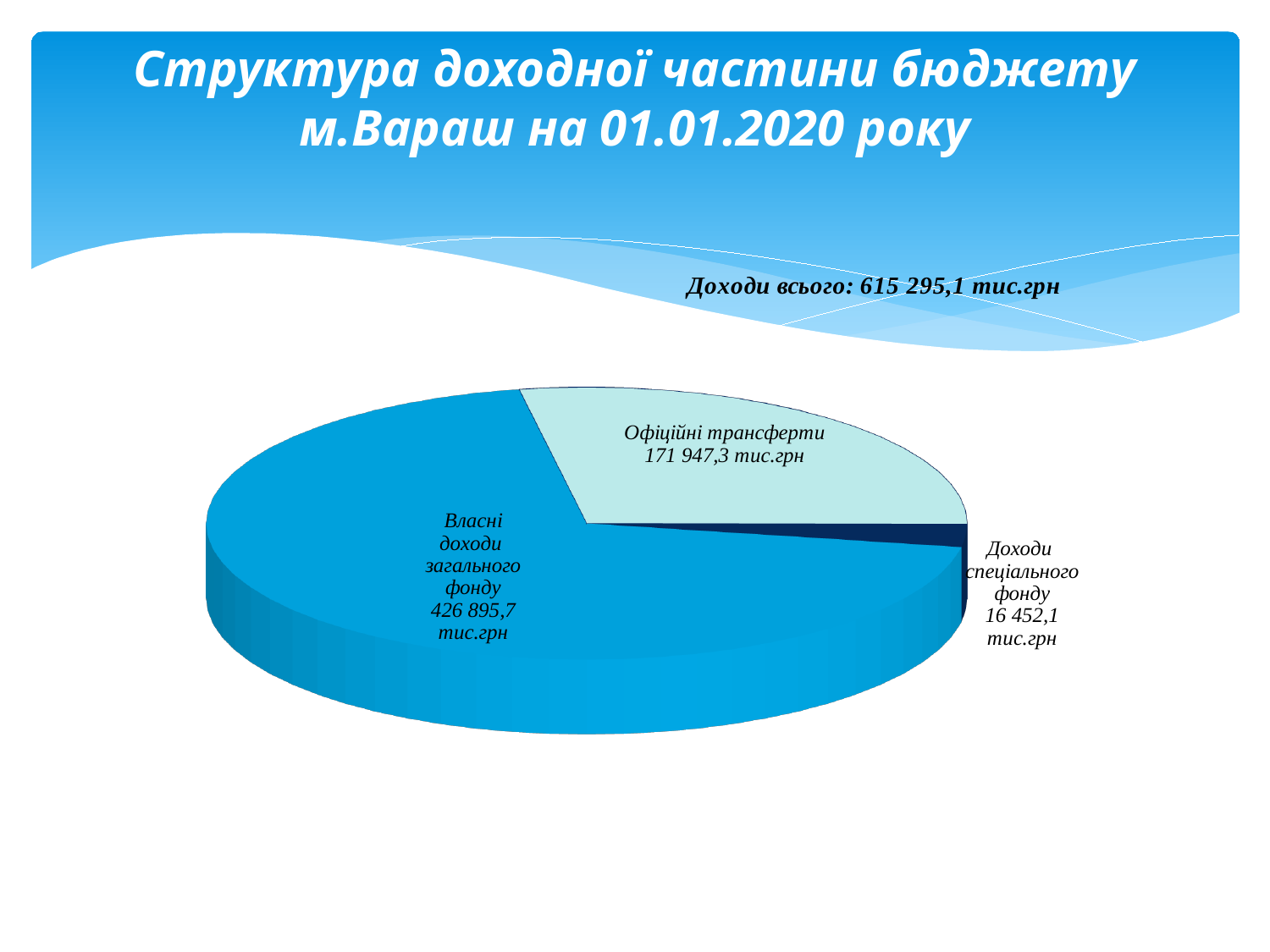
What is the difference between Офіційні трансферти and Доходи спеціального фонду? 155 495,2 тис.грн Which category has the smallest slice of the pie? Доходи спеціального фонду Which category has the largest slice of the pie? Власні доходи загального фонду How many slices does the pie chart have? 3 What is the difference between Власні доходи загального фонду and Офіційні трансферти? 254 948,4 тис.грн Which is larger, Офіційні трансферти or Доходи спеціального фонду? Офіційні трансферти What is the value for Власні доходи загального фонду? 426 895,7 тис.грн What type of chart is shown on the slide? Pie chart What is the total income (Доходи всього) shown on the slide? 615 295,1 тис.грн What is the value for Доходи спеціального фонду? 16 452,1 тис.грн What is the title of the slide containing the chart? Структура доходної частини бюджету м.Вараш на 01.01.2020 року What is the value for Офіційні трансферти? 171 947,3 тис.грн